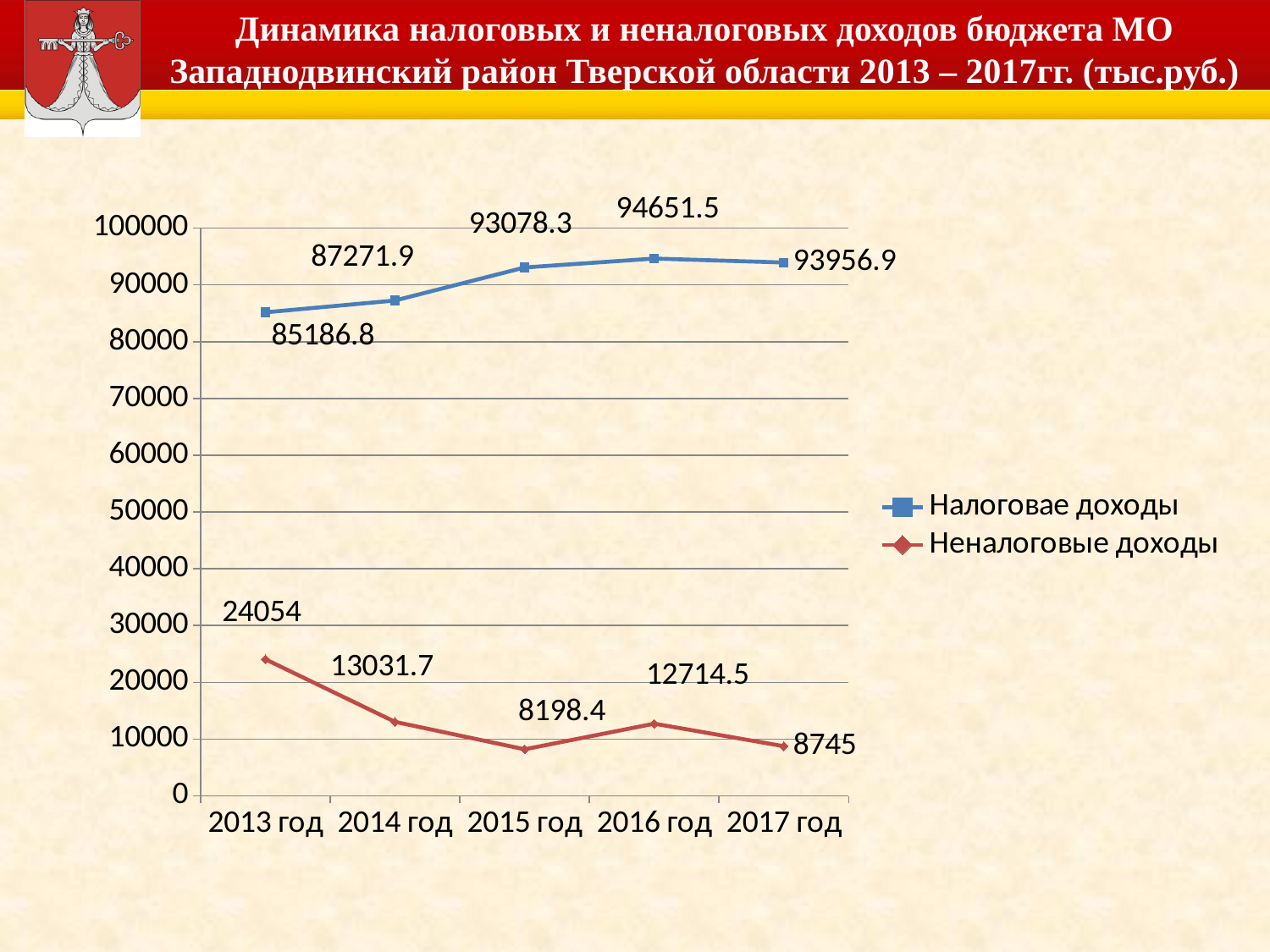
What is the value of Налоговае доходы for 2013 год? 85186.8 Is the value of Неналоговые доходы for 2013 год greater or less than 20000? greater How many series does the legend list? 2 In which year is Неналоговые доходы lowest? 2015 год What kind of chart is shown on the slide? line chart How many years are shown on the x axis? 5 In which year is Налоговае доходы highest? 2016 год By how much did Неналоговые доходы fall from 2013 год to 2014 год? 11022.3 What is the difference between Налоговае доходы in 2016 год and 2017 год? 694.6 What is the value of Неналоговые доходы for 2016 год? 12714.5 What is the value of Налоговае доходы for 2017 год? 93956.9 Which is larger: Неналоговые доходы in 2014 год or in 2016 год? 2014 год